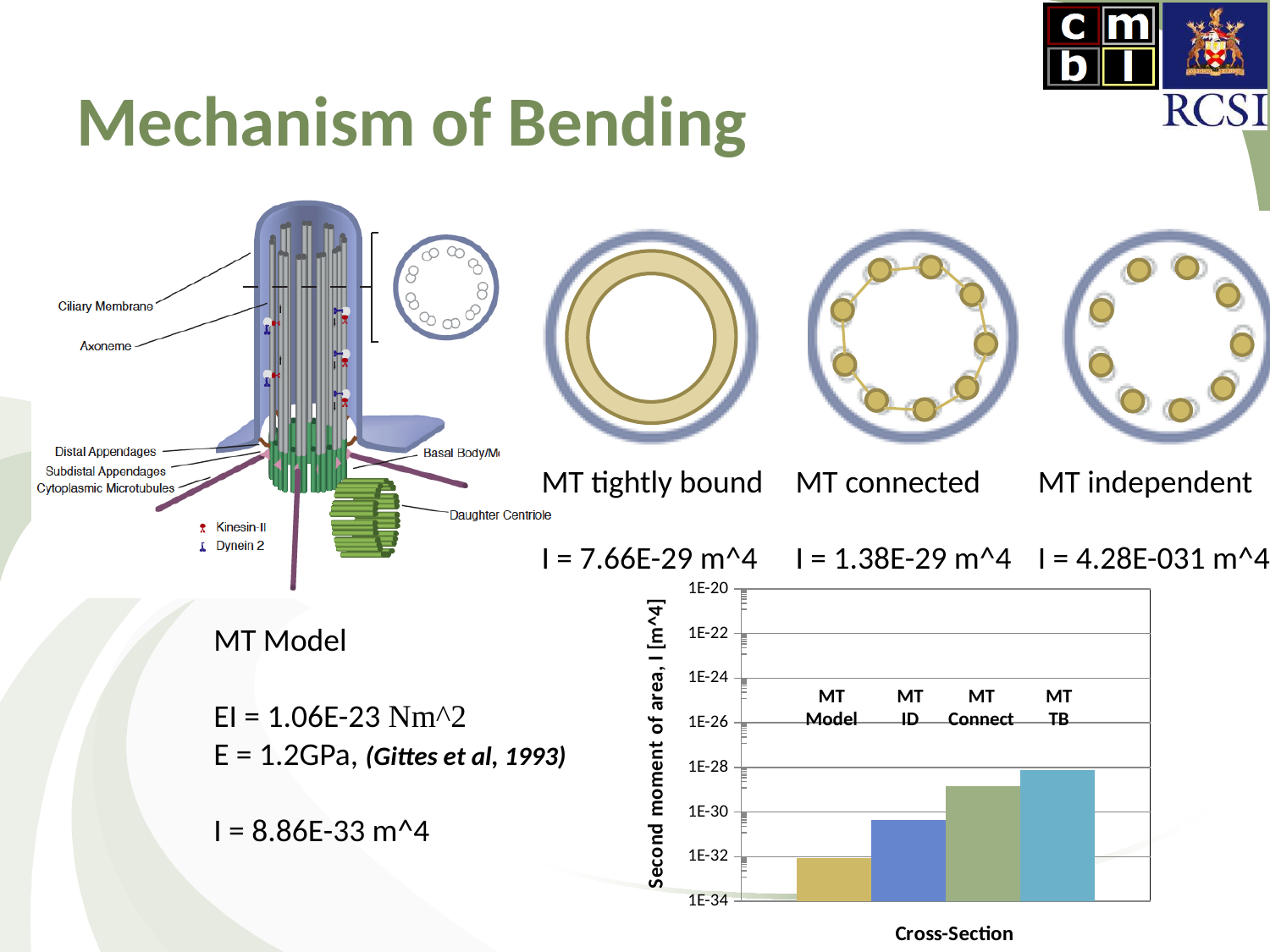
What is the label of the vertical axis of the bar chart? Second moment of area, I [m^4] Is the value for MT ID in the bar chart greater or less than 1E-32? greater Is the value for MT Connect in the bar chart greater or less than 1E-30? greater Is the value for MT TB in the bar chart greater or less than 1E-30? greater What kind of chart is shown on the slide? bar chart Do the bar values rise or fall moving from MT Model to MT TB along the x axis? rise Which is larger in the bar chart, the value for MT Model or the value for MT TB? MT TB How many cross-section categories are plotted in the bar chart? 4 Which cross-section has the lowest second moment of area in the bar chart? MT Model Which is larger in the bar chart, the value for MT Connect or the value for MT ID? MT Connect Which cross-section has the highest second moment of area in the bar chart? MT TB